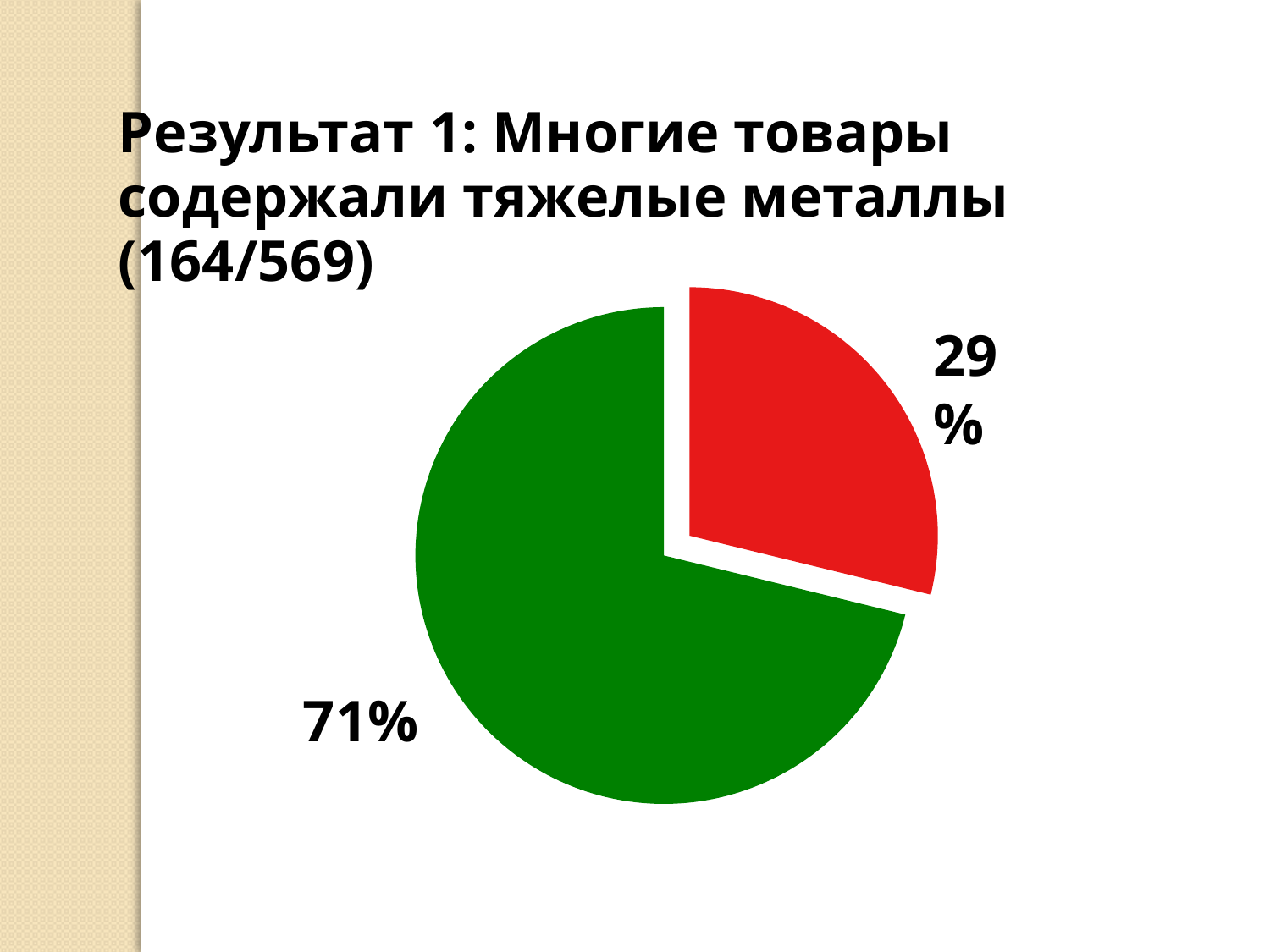
How many slices does the pie chart have? 2 Which slice of the pie chart is the largest? the green slice (71%) What kind of chart is shown on the slide? pie chart What is the difference in percentage points between the green slice and the red slice? 42 Which slice is larger, the red one or the green one? the green one What colour is the slice that is pulled out from the rest of the pie? red What share of the pie does the red slice represent? 29% What is the title of the slide containing the pie chart? Результат 1: Многие товары содержали тяжелые металлы (164/569) Which slice of the pie chart is the smallest? the red slice (29%) Is the share of the green slice greater or less than 50%? greater What percentage is shown for the red slice of the pie chart? 29% What percentage is shown for the green slice of the pie chart? 71%